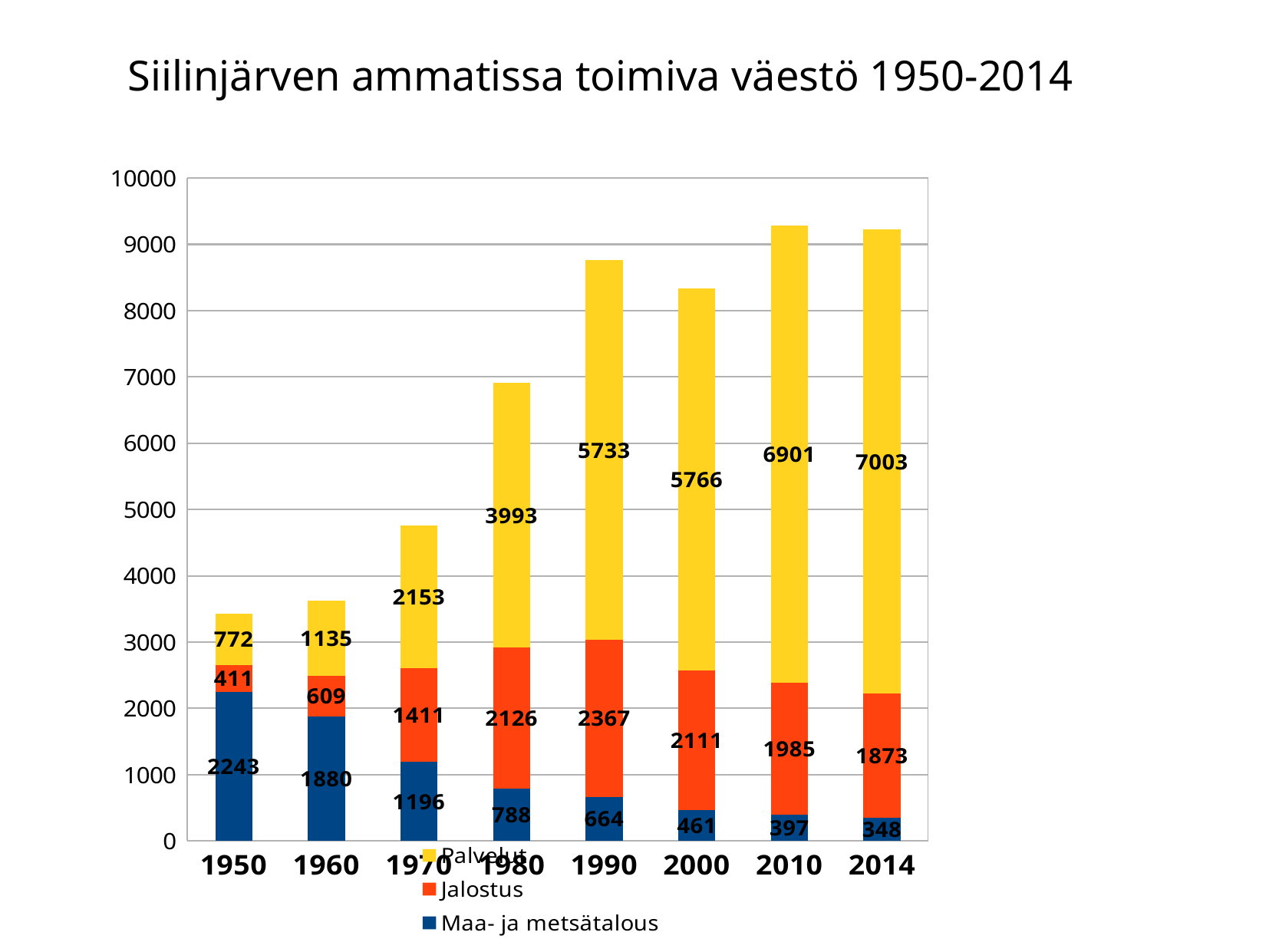
In which year is the Palvelut value highest? 2014 What is the total of the stacked bar for 2014? 9224 What is the difference between the Palvelut values in 2010 and 2000? 1135 What is the total of the stacked bar for 1950? 3426 In which year is the Maa- ja metsätalous value lowest? 2014 What is the value for Maa- ja metsätalous in 1950? 2243 How many series does the legend list? 3 What is the value for Palvelut in 2014? 7003 What type of chart is shown on the slide? stacked bar chart How many years are shown on the x axis? 8 Which is larger, the Jalostus value in 1980 or in 2000? 1980 What is the value for Jalostus in 1990? 2367